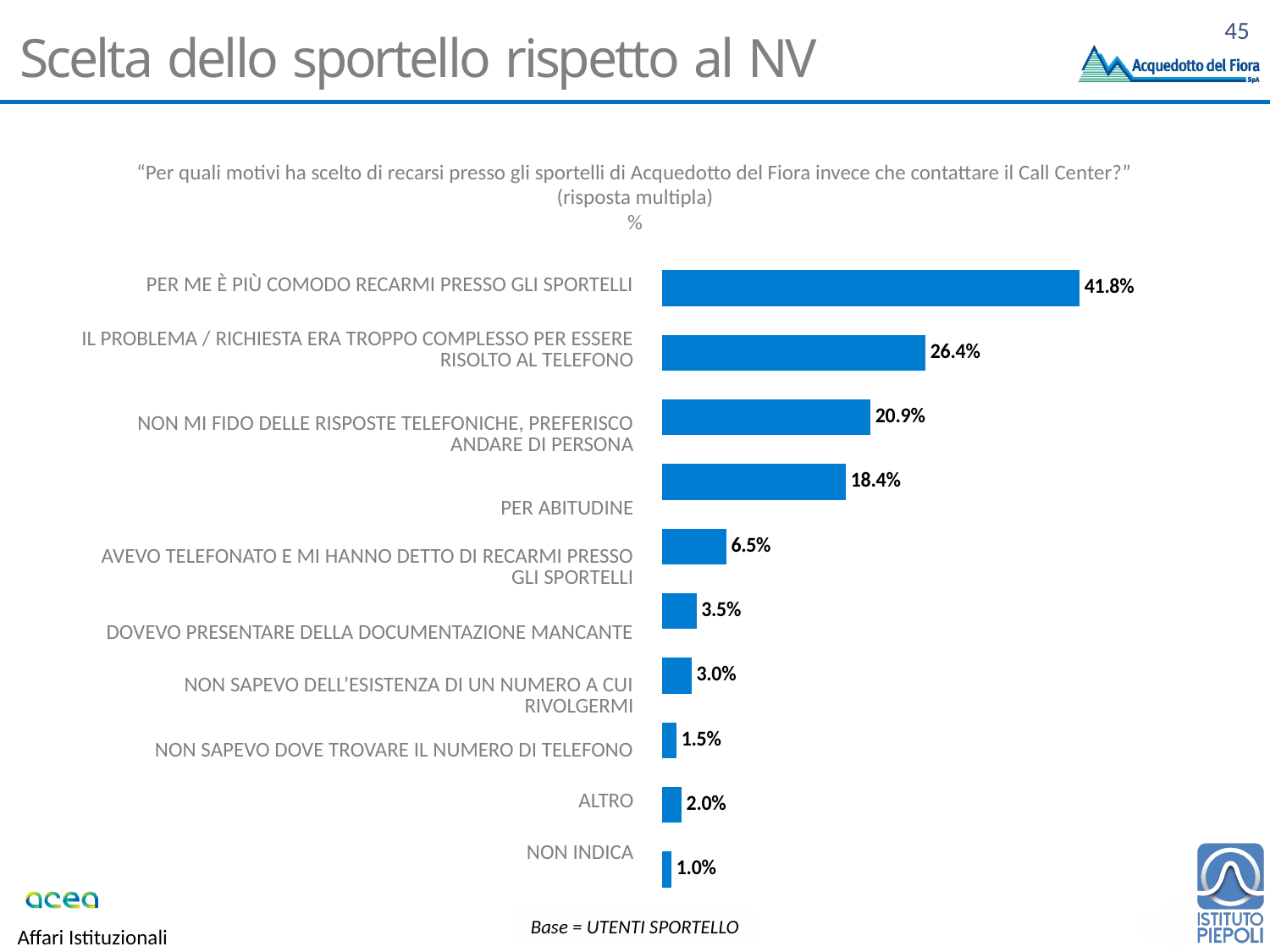
What is the base of respondents stated below the chart? UTENTI SPORTELLO What type of chart is shown on the slide? Bar chart Which is larger: "ALTRO" or "NON SAPEVO DOVE TROVARE IL NUMERO DI TELEFONO"? ALTRO What is the value shown for "PER ABITUDINE"? 18.4% Which reason has the highest percentage? PER ME È PIÙ COMODO RECARMI PRESSO GLI SPORTELLI What percentage is shown for "NON SAPEVO DOVE TROVARE IL NUMERO DI TELEFONO"? 1.5% What is the difference between "PER ME È PIÙ COMODO RECARMI PRESSO GLI SPORTELLI" and "IL PROBLEMA / RICHIESTA ERA TROPPO COMPLESSO PER ESSERE RISOLTO AL TELEFONO"? 15.4% Which is larger: "NON MI FIDO DELLE RISPOSTE TELEFONICHE, PREFERISCO ANDARE DI PERSONA" or "PER ABITUDINE"? NON MI FIDO DELLE RISPOSTE TELEFONICHE, PREFERISCO ANDARE DI PERSONA What percentage of respondents chose "PER ME È PIÙ COMODO RECARMI PRESSO GLI SPORTELLI"? 41.8% How many categories are shown in the chart? 10 Which category has the lowest percentage? NON INDICA What is the value for "ALTRO"? 2.0%